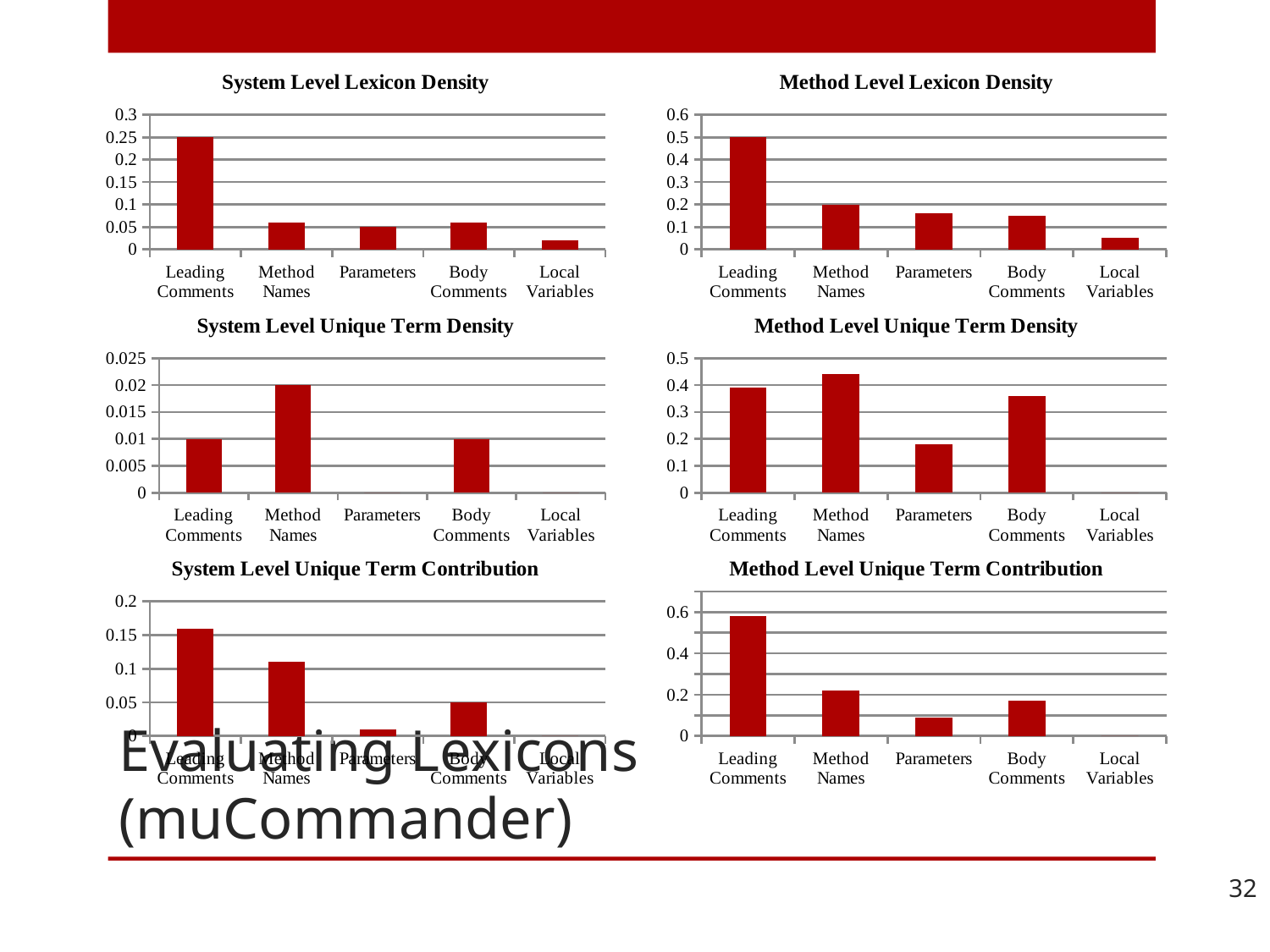
In the Method Level Lexicon Density chart, what is the value for Leading Comments? 0.5 In the Method Level Unique Term Contribution chart, which is larger, the value for Method Names or the value for Parameters? Method Names In the Method Level Unique Term Contribution chart, which category has the highest value? Leading Comments In the System Level Unique Term Contribution chart, is the value for Leading Comments greater or less than 0.15? greater In the System Level Lexicon Density chart, which category has the lowest value? Local Variables How many charts are shown on the slide? 6 In the System Level Unique Term Density chart, what is the value for Method Names? 0.02 In the System Level Unique Term Density chart, which category has the highest value? Method Names In the System Level Lexicon Density chart, what is the value for Leading Comments? 0.25 In the Method Level Unique Term Density chart, which category has the highest value? Method Names In the Method Level Unique Term Density chart, is the value for Parameters greater or less than 0.2? less In the Method Level Lexicon Density chart, what is the value for Method Names? 0.2